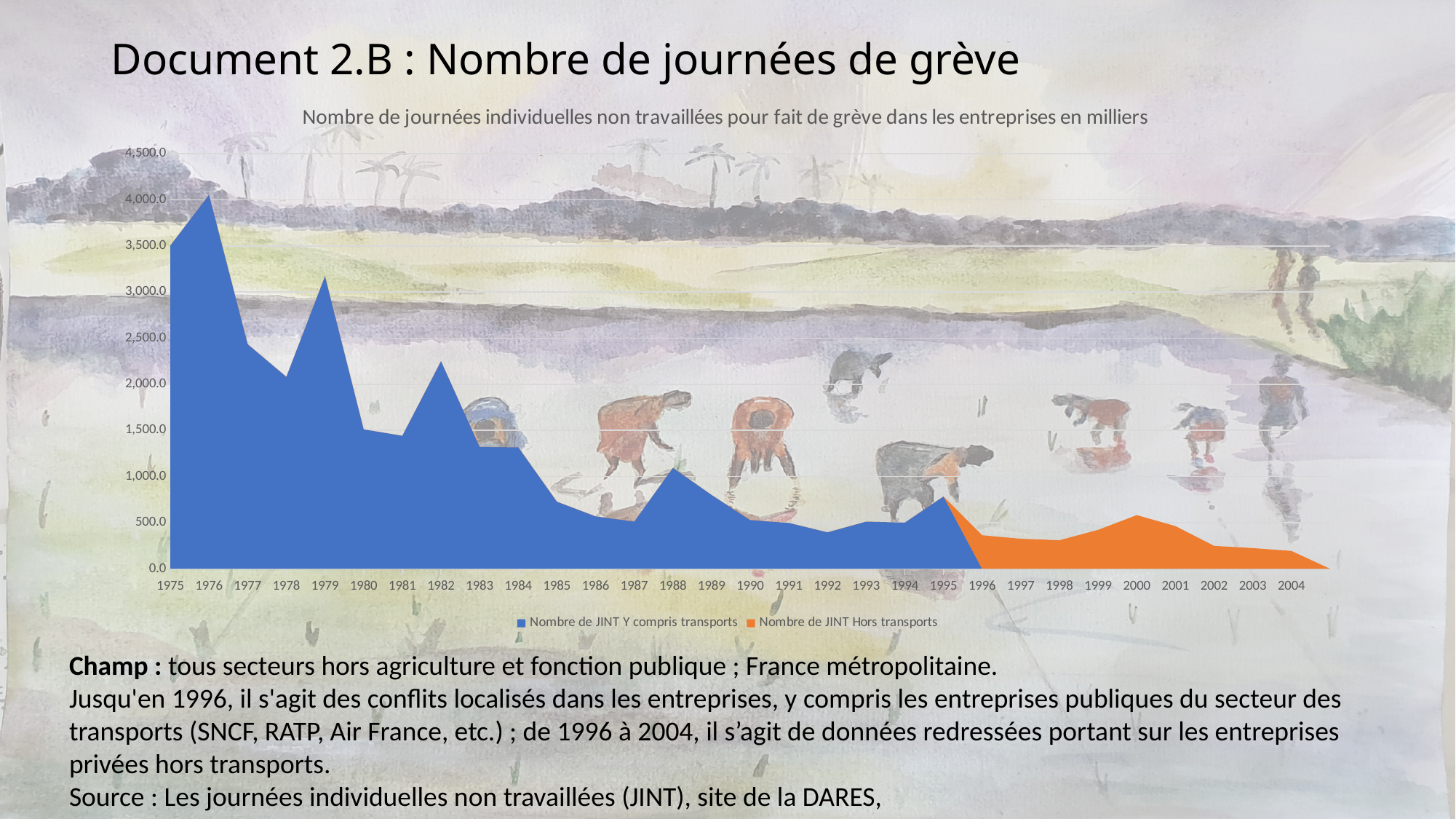
Which year has the larger value, 1976 or 1979? 1976 How many series does the legend list? 2 Is the value for 1992 greater or less than 500.0? less Which year has the highest number of strike days? 1976 How many years are shown on the x axis? 30 Is the value for 1982 greater or less than 2,000.0? greater What kind of chart is shown on the slide? area chart Is the value for 1976 greater or less than 3,500.0? greater Do the values generally rise or fall from 1975 to 1995? fall Which series is shown in orange? Nombre de JINT Hors transports